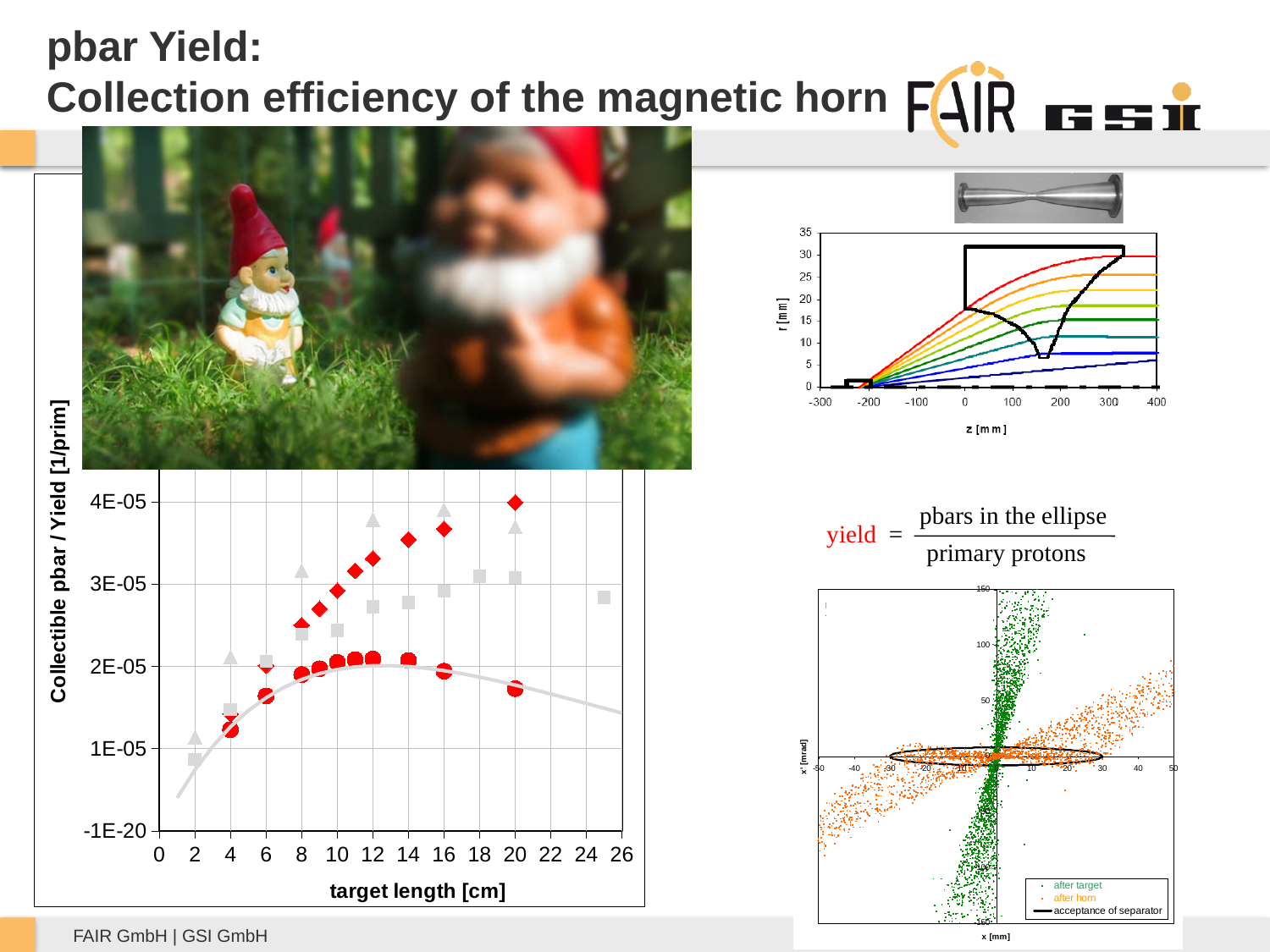
What is the y-axis label of the large chart on the left of the slide? Collectible pbar / Yield [1/prim] What is the x-axis label of the large chart on the left of the slide? target length [cm] How many entries does the legend of the phase-space scatter chart at the bottom right list? 3 What is the x-axis label of the small chart at the top right showing r versus z? z [mm] In the large chart on the left, is the value of the red diamond series at a target length of 20 cm greater or less than 3E-05? greater What kind of chart is the large chart on the left of the slide? scatter chart In the large chart on the left, at a target length of 20 cm, which is larger: the red diamond value or the red circle value? red diamond In the large chart on the left, do the red diamond values rise or fall as target length increases from 4 cm to 20 cm? rise In the large chart on the left, is the value of the red diamond series at a target length of 14 cm greater or less than 3E-05? greater In the large chart on the left, is the value of the red circle series at a target length of 4 cm greater or less than 2E-05? less